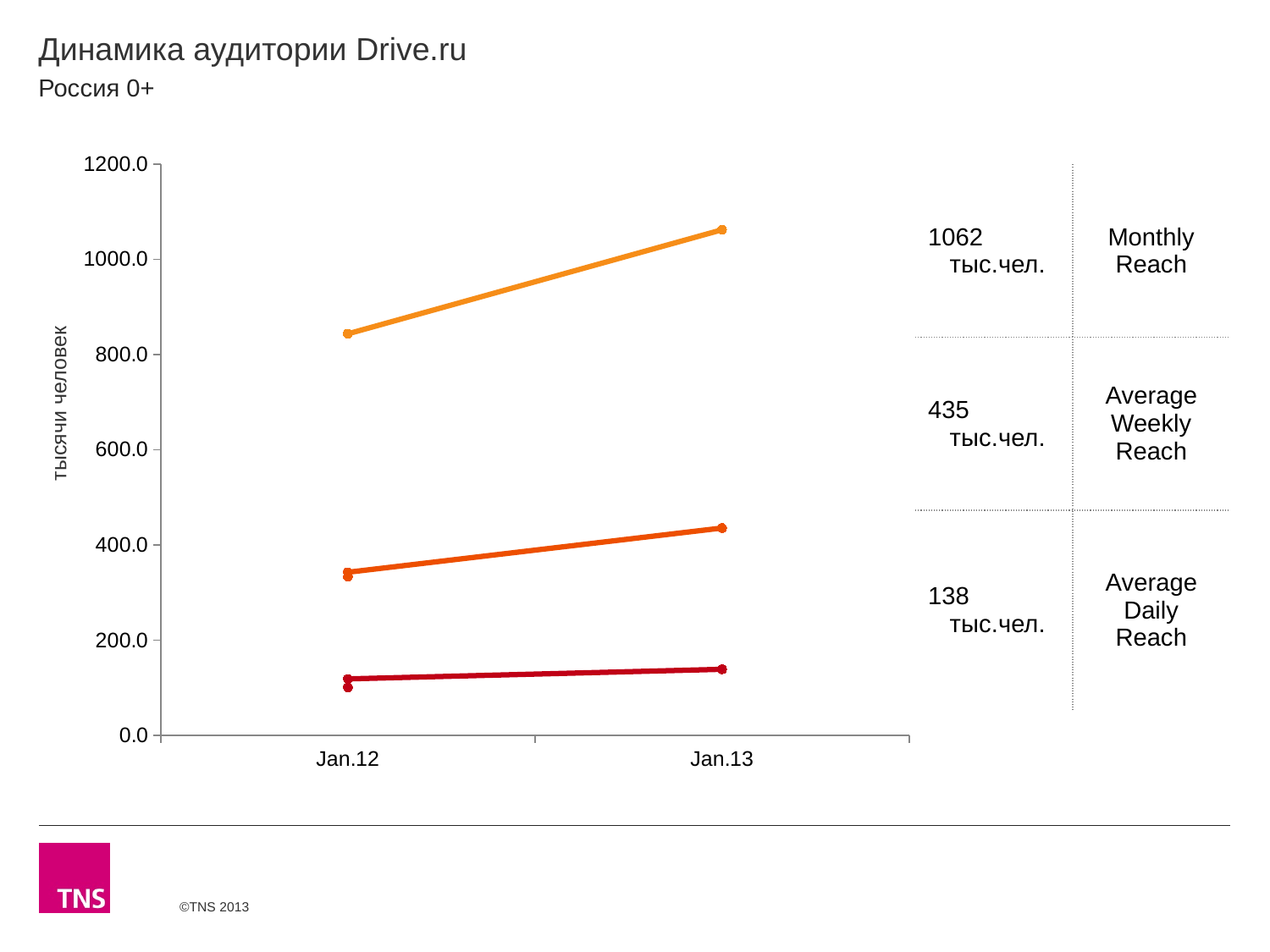
What is the Average Weekly Reach value for Jan.13? 435 тыс.чел. Does the Monthly Reach line rise or fall from Jan.12 to Jan.13? rise Which of the three reach measures has the highest value in Jan.13? Monthly Reach What is the Monthly Reach value for Jan.13? 1062 тыс.чел. What is the label of the y axis? тысячи человек Is the Monthly Reach value for Jan.12 greater or less than 800? greater How many lines are plotted on the chart? 3 What is the difference between Monthly Reach and Average Weekly Reach in Jan.13? 627 тыс.чел. What is the Average Daily Reach value for Jan.13? 138 тыс.чел. What kind of chart is shown on the slide? line chart How many time points are shown on the x axis of the chart? 2 Which of the three reach measures has the lowest value in Jan.13? Average Daily Reach